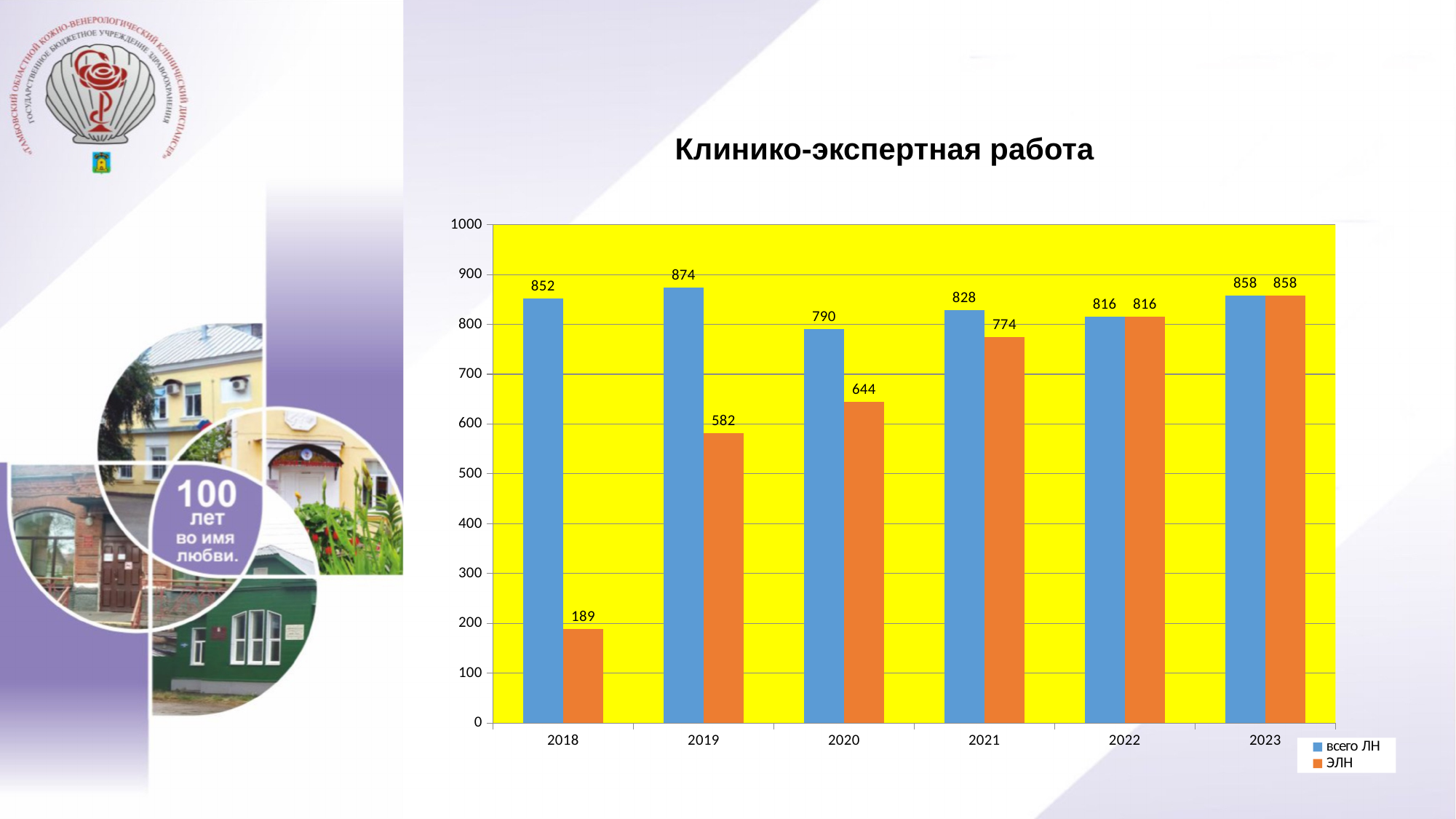
In which year is всего ЛН highest? 2019 In which year is ЭЛН lowest? 2018 What is the difference between всего ЛН and ЭЛН in 2020? 146 Does the ЭЛН series rise or fall from 2018 to 2023? rise What is the value of ЭЛН for 2019? 582 What kind of chart is shown on the slide? bar chart What is the value of ЭЛН for 2021? 774 Which is larger in 2019: всего ЛН or ЭЛН? всего ЛН How many series does the legend list? 2 How many years are shown on the x axis? 6 What is the difference between всего ЛН and ЭЛН in 2018? 663 What is the value of всего ЛН for 2018? 852